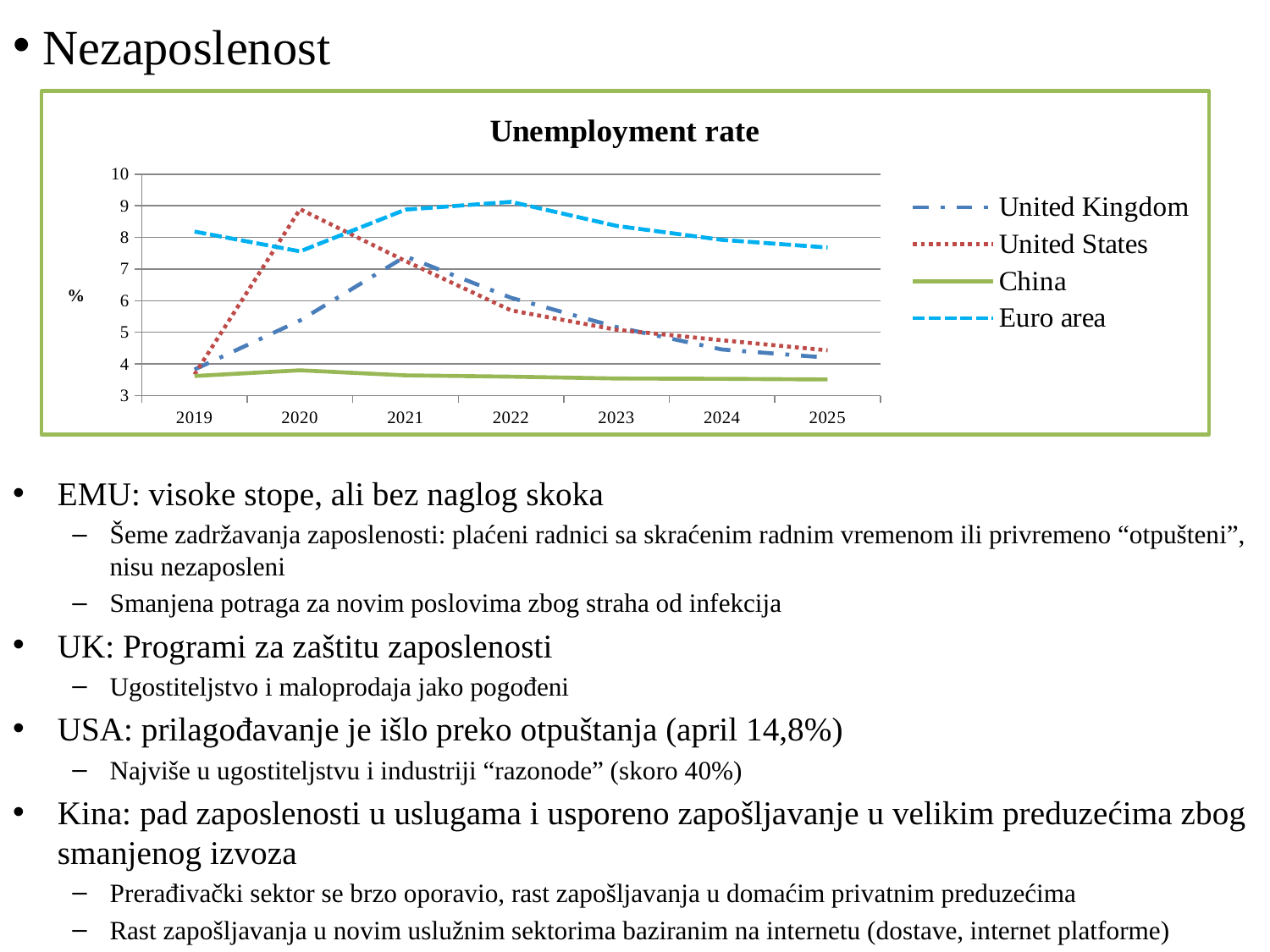
Is the value for the United Kingdom in 2025 greater or less than 5? less Does the United States unemployment rate rise or fall from 2020 to 2025? fall How many series does the legend of the Unemployment rate chart list? 4 What kind of chart is shown on the slide? line chart What is the title of the chart? Unemployment rate Is the value for China in 2025 greater or less than 4? less Which series has the highest unemployment rate in 2020? United States Which series has the highest unemployment rate in 2025? Euro area Is the value for the United States in 2020 greater or less than 8? greater How many years are shown on the x axis of the Unemployment rate chart? 7 Which series has the lowest unemployment rate in 2022? China In 2024, which is larger: the value for the United States or the value for the Euro area? Euro area